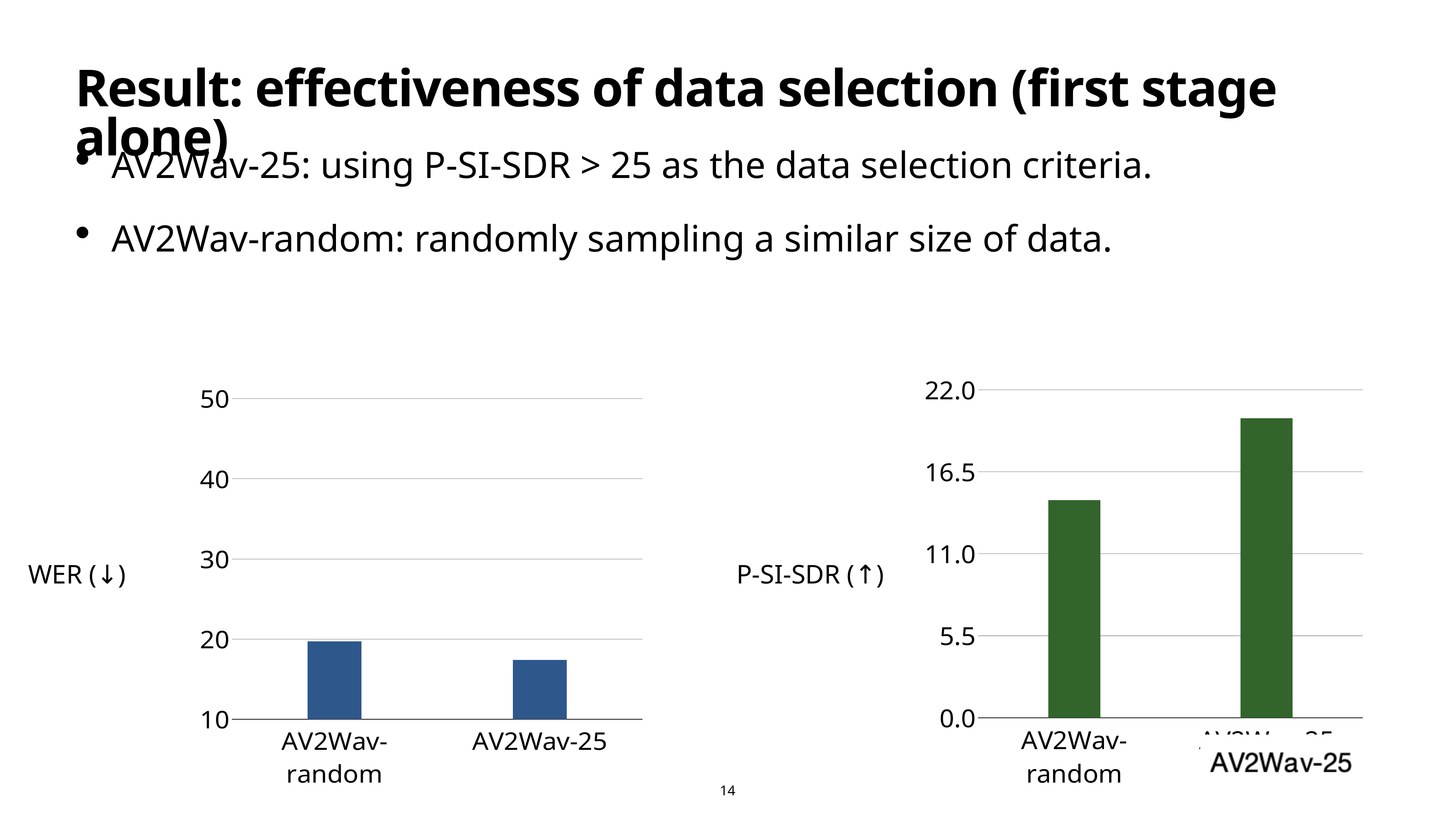
In the WER (↓) chart on the left, is the value for AV2Wav-25 greater or less than 10? greater In the WER (↓) chart on the left, which category has the lower value? AV2Wav-25 In the P-SI-SDR (↑) chart on the right, which category has the lowest value? AV2Wav-random In the P-SI-SDR (↑) chart on the right, which category has the highest value? AV2Wav-25 In the P-SI-SDR (↑) chart on the right, is the value for AV2Wav-25 greater or less than 16.5? greater How many categories are shown in the WER (↓) chart on the left? 2 In the WER (↓) chart on the left, which category has the higher value? AV2Wav-random What kind of chart is the WER (↓) chart on the left? bar chart In the P-SI-SDR (↑) chart on the right, which is larger: the value for AV2Wav-random or the value for AV2Wav-25? AV2Wav-25 In the P-SI-SDR (↑) chart on the right, is the value for AV2Wav-random greater or less than 16.5? less What colour are the bars in the P-SI-SDR (↑) chart on the right? green